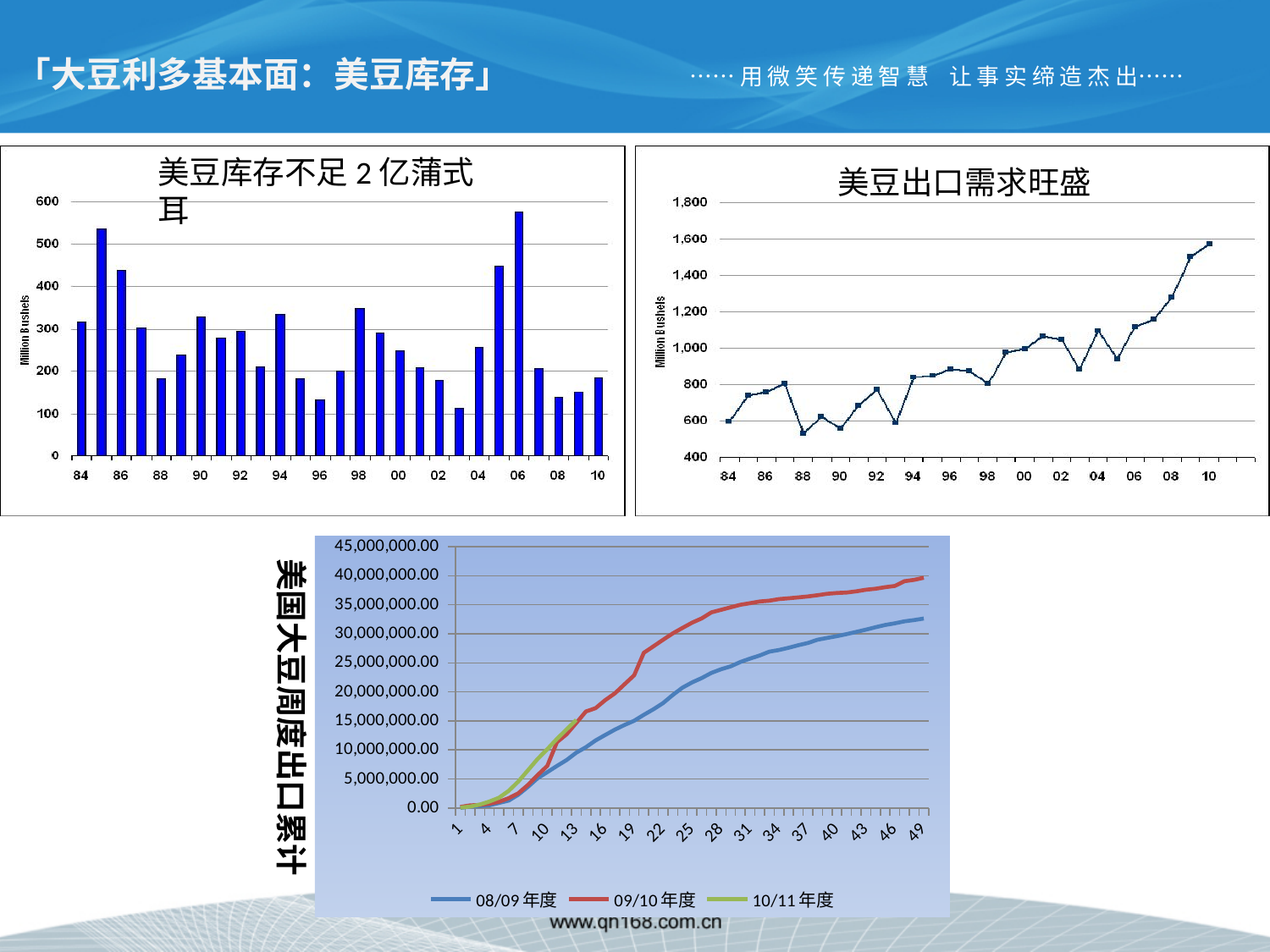
In the bottom chart (美国大豆周度出口累计), which series is higher at week 49, 08/09年度 or 09/10年度? 09/10年度 In the top-left chart (美豆库存不足2亿蒲式耳), which year has the lowest bar? 03 In the top-right chart (美豆出口需求旺盛), which year has the lowest value? 88 In the top-right chart (美豆出口需求旺盛), is the value for 10 greater or less than 1,400? greater What type of chart is the top-left chart titled 美豆库存不足2亿蒲式耳? bar chart In the top-left chart (美豆库存不足2亿蒲式耳), is the value for 96 greater or less than 200? less How many series does the legend of the bottom chart (美国大豆周度出口累计) list? 3 In the top-right chart (美豆出口需求旺盛), which year has the highest value? 10 In the top-right chart (美豆出口需求旺盛), do the values generally rise or fall from 84 to 10? rise In the top-left chart (美豆库存不足2亿蒲式耳), is the value for 06 greater or less than 500? greater In the top-left chart (美豆库存不足2亿蒲式耳), which is larger, the value for 85 or the value for 05? 85 In the top-left chart (美豆库存不足2亿蒲式耳), which year has the highest bar? 06